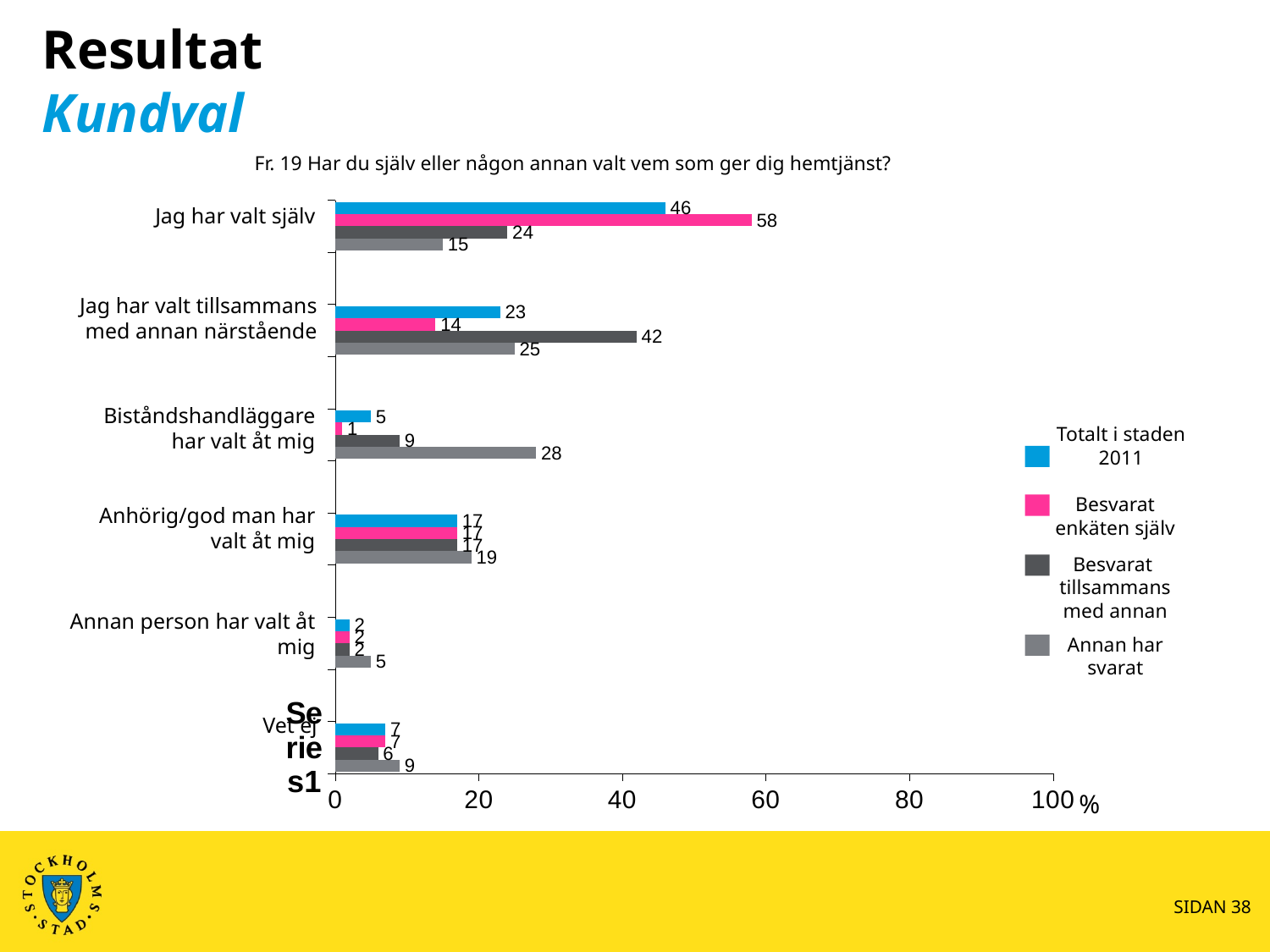
Which category has the lowest value in the 'Annan har svarat' series? Annan person har valt åt mig What is the value for 'Biståndshandläggare har valt åt mig' in the 'Annan har svarat' series? 28 What is the value for 'Jag har valt tillsammans med annan närstående' in the 'Besvarat tillsammans med annan' series? 42 What is the difference between the 'Besvarat enkäten själv' and 'Totalt i staden 2011' values for 'Jag har valt själv'? 12 Is the 'Besvarat enkäten själv' value for 'Jag har valt själv' greater or less than 40? greater What kind of chart is shown on the slide? Bar chart What is the value for 'Jag har valt själv' in the 'Besvarat enkäten själv' series? 58 How many categories are shown on the chart? 6 Which category has the highest value in the 'Besvarat enkäten själv' series? Jag har valt själv How many series does the legend list? 4 What is the value for 'Jag har valt själv' in the 'Totalt i staden 2011' series? 46 For 'Jag har valt tillsammans med annan närstående', which is larger: the 'Besvarat tillsammans med annan' value or the 'Annan har svarat' value? Besvarat tillsammans med annan